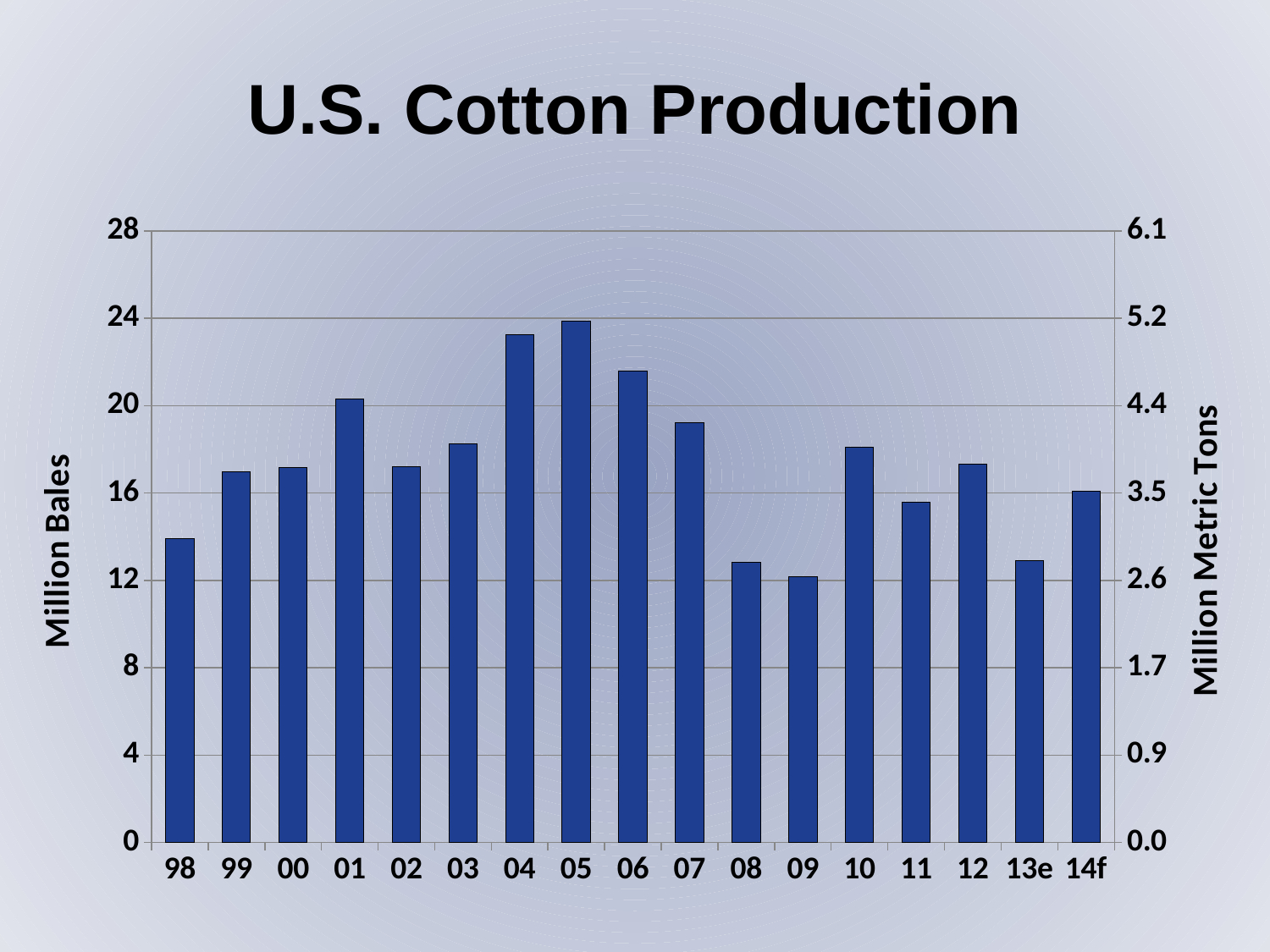
Is the value for 98 greater or less than 16 million bales? less Which year has the highest cotton production? 05 Is the value for 06 greater or less than 20 million bales? greater Which year has the larger production, 06 or 10? 06 Is the value for 11 greater or less than 16 million bales? less Which year has the lowest cotton production? 09 What is the title of the chart? U.S. Cotton Production How many years (bars) are shown on the x axis? 17 What is the label on the left vertical axis? Million Bales Do the values rise or fall from 05 to 09? fall What type of chart is shown on the slide? bar chart